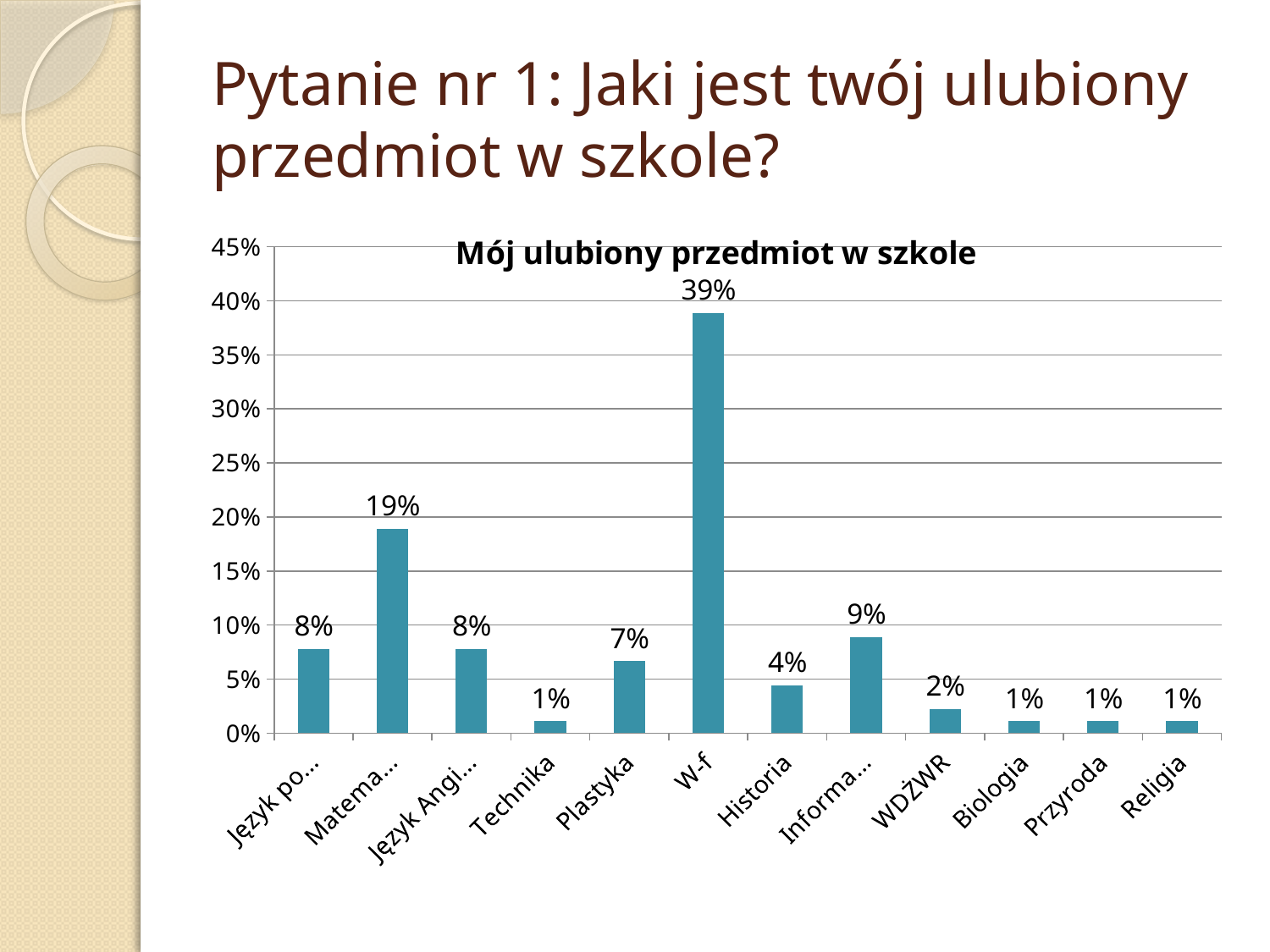
What is the difference between the values for W-f and Plastyka? 32% Which is larger, the value for Historia or the value for Plastyka? Plastyka What is the value for Plastyka? 7% How many subjects are shown on the x axis? 12 What is the value for WDŻWR? 2% Which subject has the highest value? W-f What is the value for Technika? 1% What kind of chart is shown on the slide? bar chart What is the value for Historia? 4% Is the value for W-f greater or less than 35%? greater What is the value for W-f? 39% What is the difference between the values for Historia and WDŻWR? 2%